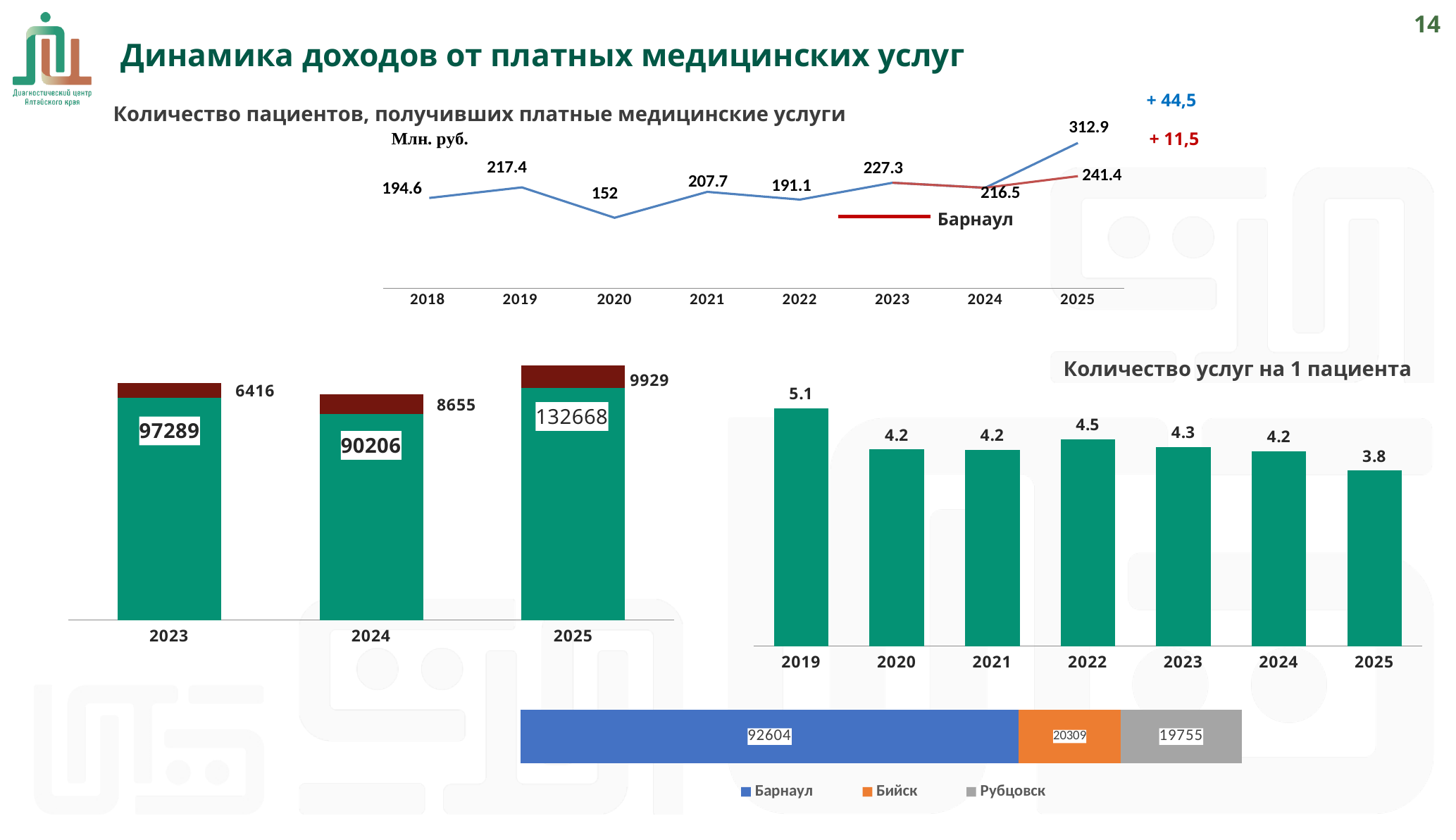
In the bottom-left stacked bar chart, what is the value of the large green segment for 2025? 132668 In the top line chart (Млн. руб.), what is the value for 2025 on the blue line? 312.9 In the top line chart (Млн. руб.), what is the value for 2020? 152 In the top line chart (Млн. руб.), what is the value for 2025 on the red Барнаул line? 241.4 In the top line chart (Млн. руб.), what is the difference between the 2025 blue-line value and the 2024 value (312.9 and 216.5)? 96.4 In the top line chart (Млн. руб.), which year has the lowest value on the blue line? 2020 In the horizontal stacked bar at the bottom of the slide, what is the value for Бийск? 20309 In the bottom-left stacked bar chart, which year has the larger green segment, 2023 or 2024? 2023 In the chart 'Количество услуг на 1 пациента', how many years are shown on the x axis? 7 In the chart 'Количество услуг на 1 пациента', which year has the highest value? 2019 In the chart 'Количество услуг на 1 пациента', what is the value for 2025? 3.8 In the bottom-left stacked bar chart, what is the total of the stacked bar for 2023 (97289 and 6416)? 103705